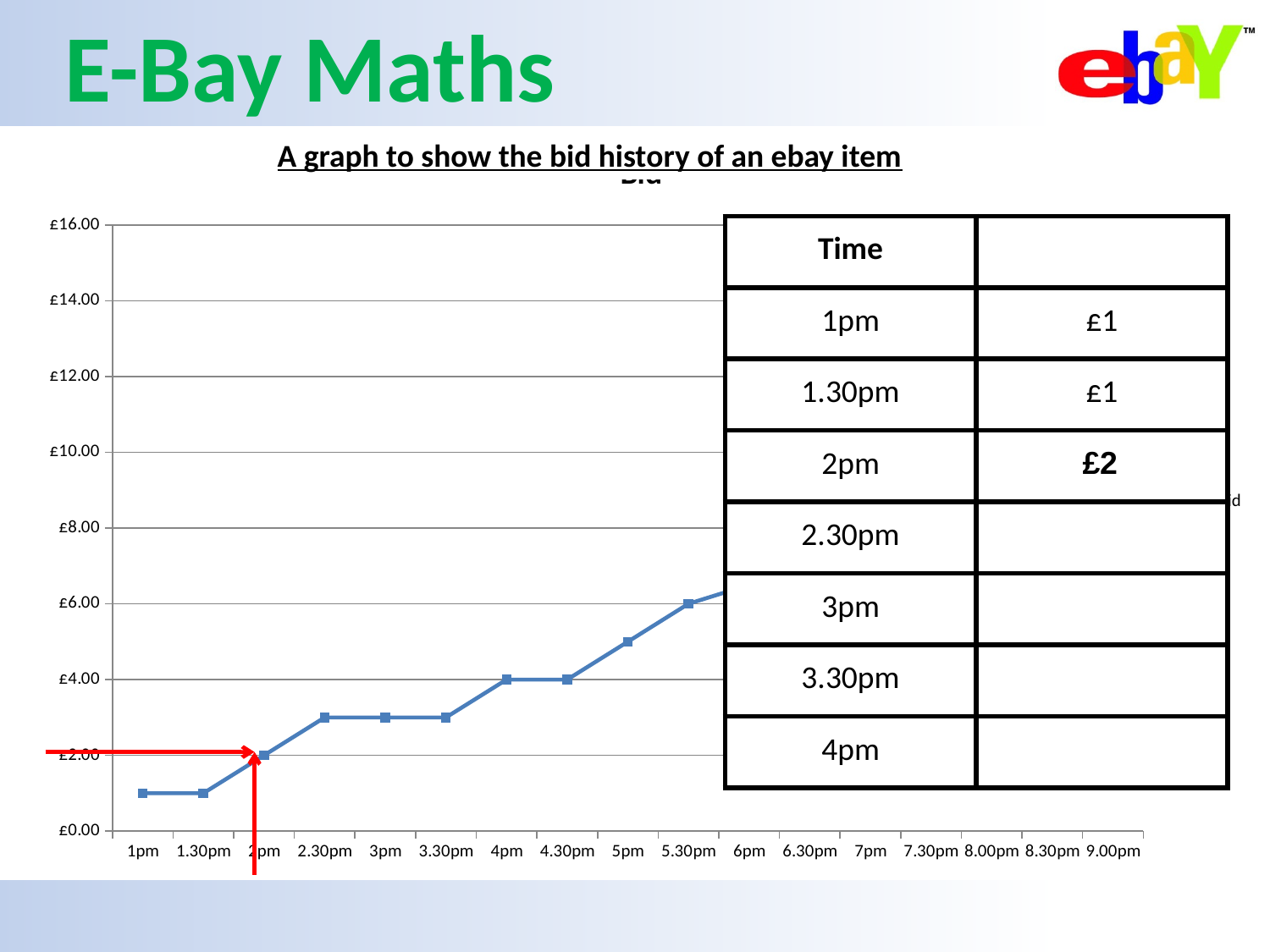
What is the bid value at 1pm? £1 Is the bid value at 5pm greater or less than £6.00? less What is the bid value at 2pm? £2 What kind of chart is shown on the slide? line chart Do the bid values rise or fall from 1pm to 5.30pm? rise How many time labels are shown on the x axis? 17 Is the bid value at 2.30pm greater or less than £2.00? greater What is the bid value at 5.30pm? £6.00 Which is larger, the bid at 2pm or the bid at 5.30pm? 5.30pm What is the highest value shown on the y axis? £16.00 What is the difference between the bid at 5.30pm and the bid at 4pm? £2.00 What is the bid value at 4pm? £4.00